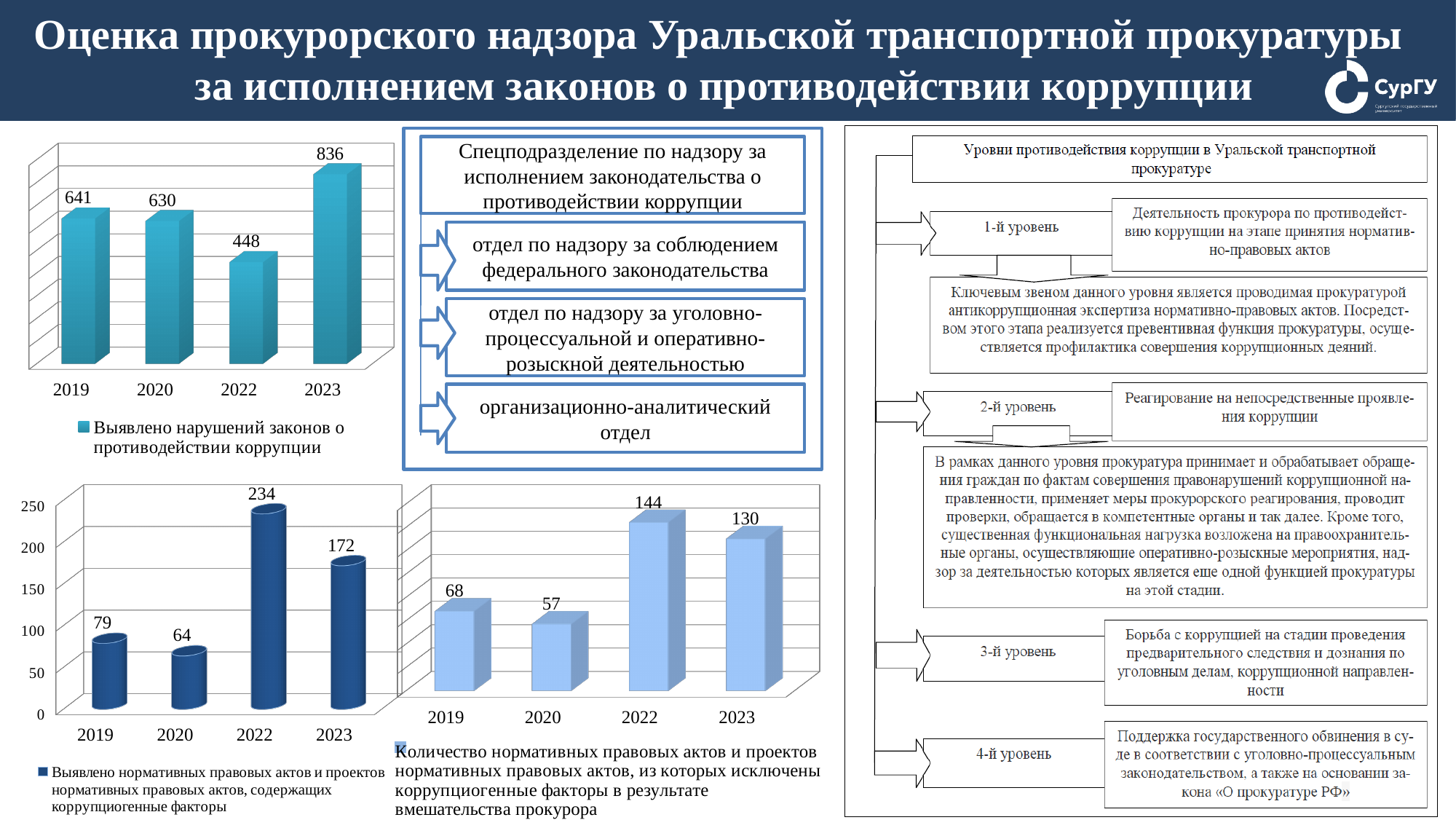
On the bottom-left chart (Выявлено нормативных правовых актов и проектов нормативных правовых актов, содержащих коррупциогенные факторы), what is the difference between the values for 2019 and 2020? 15 On the top-left chart (Выявлено нарушений законов о противодействии коррупции), what is the difference between the values for 2023 and 2022? 388 On the bottom-middle chart (Количество нормативных правовых актов и проектов нормативных правовых актов, из которых исключены коррупциогенные факторы), what is the value for 2020? 57 What type of chart is the top-left chart (Выявлено нарушений законов о противодействии коррупции)? Bar chart On the bottom-left chart (Выявлено нормативных правовых актов и проектов нормативных правовых актов, содержащих коррупциогенные факторы), which year has the highest value? 2022 On the top-left chart (Выявлено нарушений законов о противодействии коррупции), what is the value for 2023? 836 On the top-left chart (Выявлено нарушений законов о противодействии коррупции), which year has the lowest value? 2022 On the bottom-left chart (Выявлено нормативных правовых актов и проектов нормативных правовых актов, содержащих коррупциогенные факторы), is the value for 2020 greater or less than 100? less On the top-left chart (Выявлено нарушений законов о противодействии коррупции), how many years are plotted? 4 On the bottom-middle chart (Количество нормативных правовых актов и проектов нормативных правовых актов, из которых исключены коррупциогенные факторы), which is larger, the value for 2022 or the value for 2023? 2022 On the bottom-middle chart (Количество нормативных правовых актов и проектов нормативных правовых актов, из которых исключены коррупциогенные факторы), what is the difference between the values for 2022 and 2019? 76 On the bottom-left chart (Выявлено нормативных правовых актов и проектов нормативных правовых актов, содержащих коррупциогенные факторы), what is the value for 2022? 234